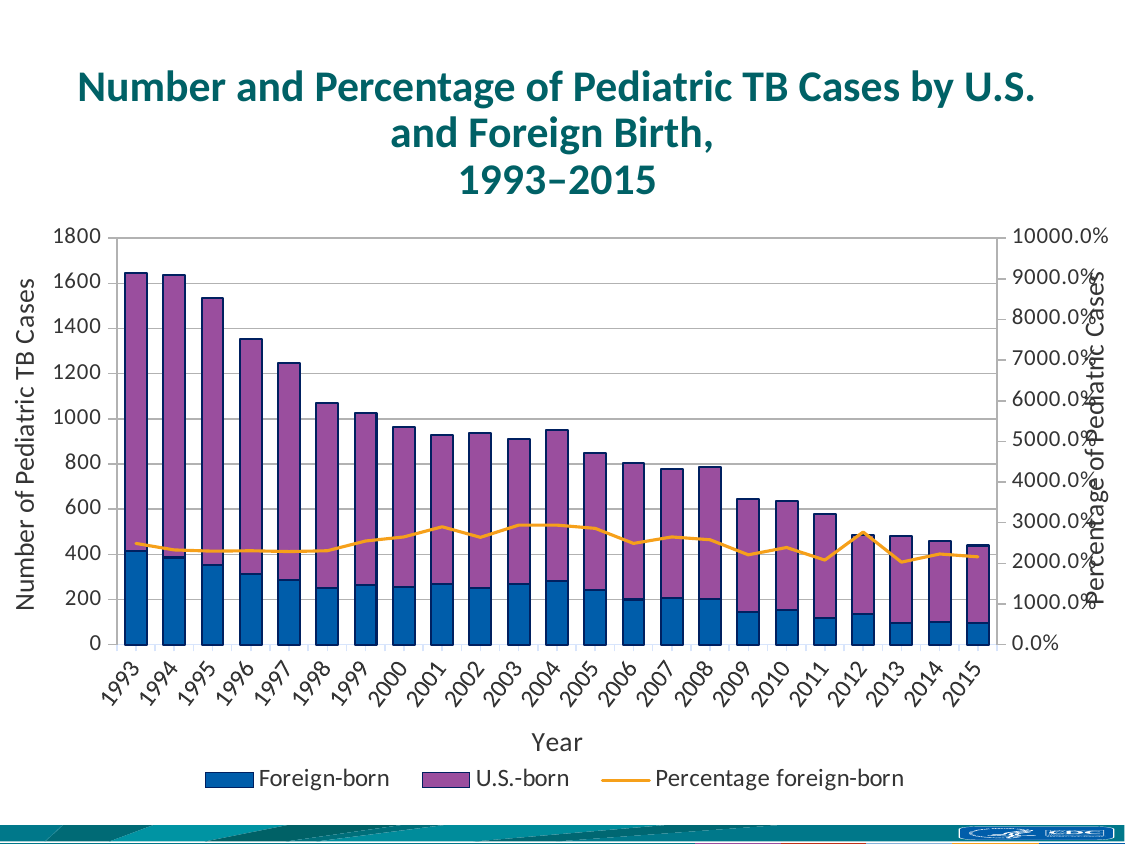
What is the label on the left vertical axis? Number of Pediatric TB Cases Does the total number of pediatric TB cases generally rise or fall from 1993 to 2015? fall Which year has the larger total number of pediatric TB cases, 1993 or 2015? 1993 What kind of chart is shown on the slide? A stacked bar chart with a line Which year has the larger total number of pediatric TB cases, 1996 or 1997? 1996 Is the total number of pediatric TB cases in 1993 greater or less than 1600? greater Is the total number of pediatric TB cases in 1995 greater or less than 1400? greater How many years are plotted along the x axis? 23 Is the total number of pediatric TB cases in 2015 greater or less than 600? less Which colour represents the Foreign-born series? Blue How many series does the legend list? 3